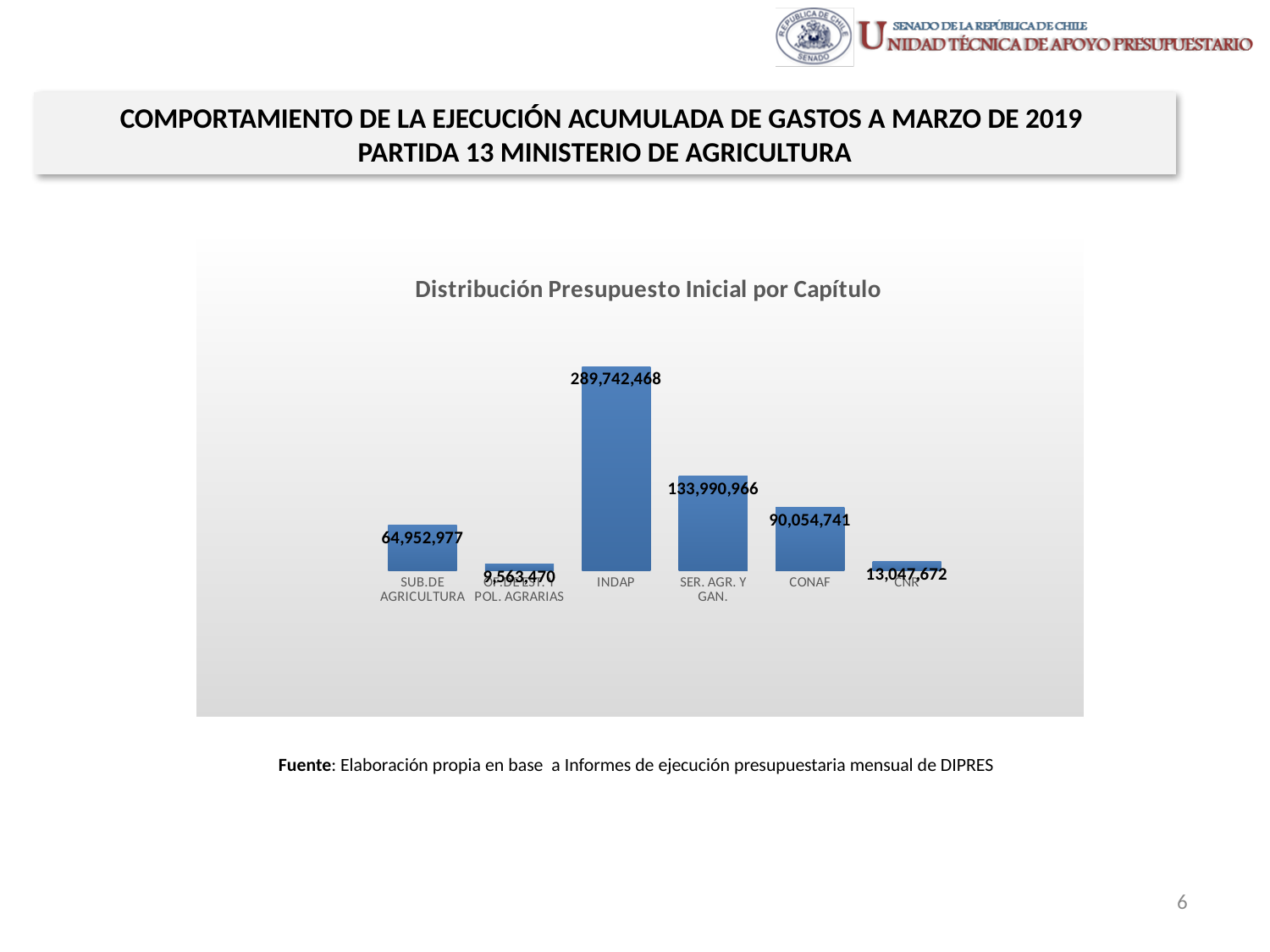
How many categories are shown in the chart? 6 Which is larger, the value for CONAF or the value for SER. AGR. Y GAN.? SER. AGR. Y GAN. What is the difference between the values for CONAF and SUB.DE AGRICULTURA? 25,101,764 What is the value for SUB.DE AGRICULTURA in the chart? 64,952,977 Which category has the highest value in the chart? INDAP What is the value for CNR in the chart? 13,047,672 What is the value for SER. AGR. Y GAN. in the chart? 133,990,966 What is the value for CONAF in the chart? 90,054,741 What is the difference between the values for INDAP and SER. AGR. Y GAN.? 155,751,502 What is the value for INDAP in the chart? 289,742,468 What is the title of the chart? Distribución Presupuesto Inicial por Capítulo What kind of chart is shown on the slide? Bar chart